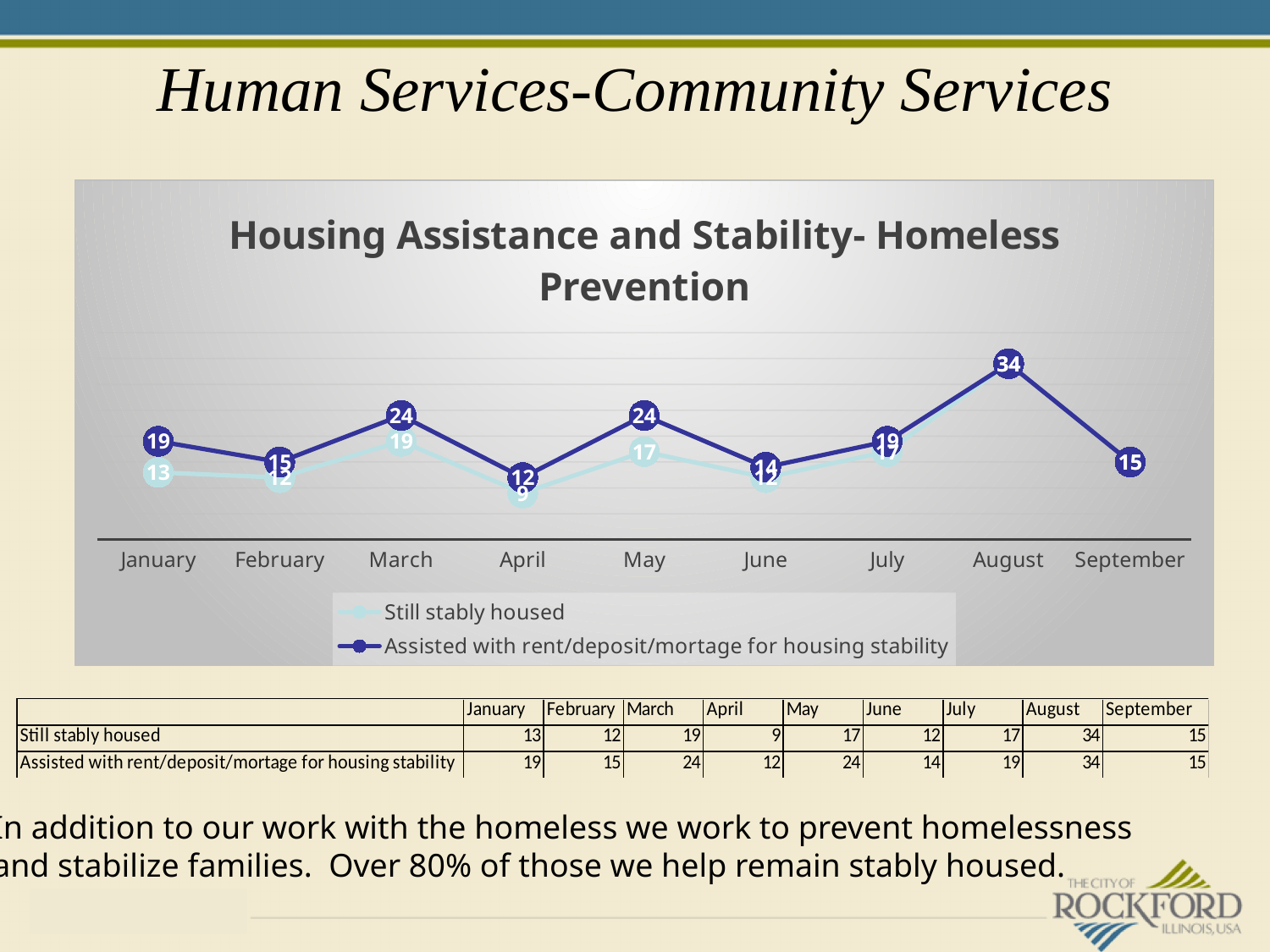
What is the title of the chart? Housing Assistance and Stability- Homeless Prevention What is the value for 'Still stably housed' in August? 34 What type of chart is shown on the slide? Line chart Does the 'Assisted with rent/deposit/mortage for housing stability' series rise or fall from August to September? Fall In which month is the 'Assisted with rent/deposit/mortage for housing stability' value highest? August Which is larger in January: the 'Assisted with rent/deposit/mortage for housing stability' value or the 'Still stably housed' value? Assisted with rent/deposit/mortage for housing stability How many series does the chart legend list? 2 How many months are plotted along the x axis of the chart? 9 What is the value for 'Assisted with rent/deposit/mortage for housing stability' in March? 24 What is the difference between the 'Assisted with rent/deposit/mortage for housing stability' value and the 'Still stably housed' value in May? 7 In which month is the 'Still stably housed' value lowest? April What is the value for 'Still stably housed' in April? 9